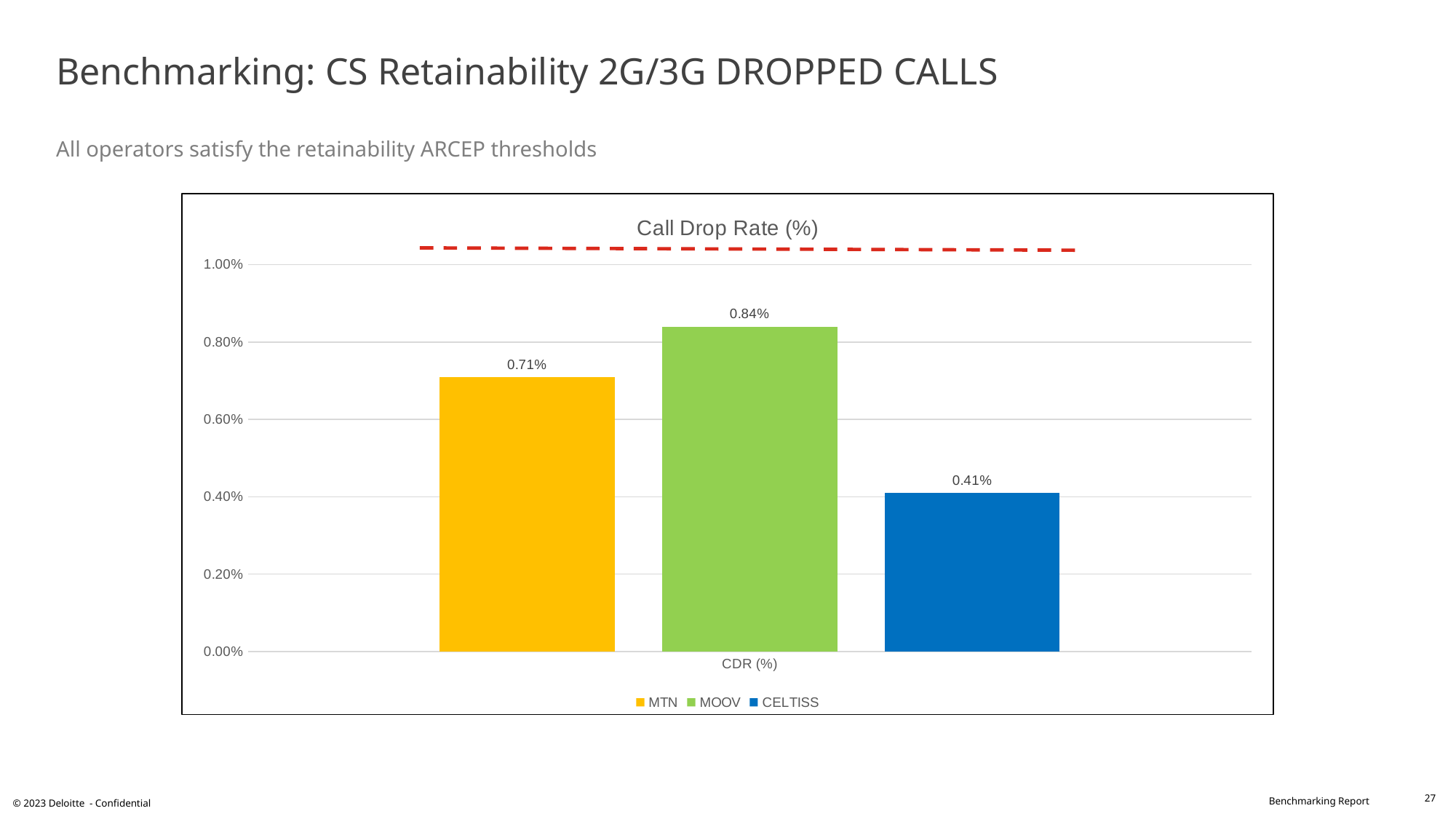
Which operator has the highest Call Drop Rate? MOOV How many series does the legend list? 3 What is the difference between the Call Drop Rate of MTN and CELTISS? 0.30% What kind of chart is shown on the slide? Bar chart What is the Call Drop Rate for CELTISS? 0.41% What is the difference between the Call Drop Rate of MOOV and MTN? 0.13% Is the Call Drop Rate for MOOV greater or less than 1.00%? less What is the Call Drop Rate for MTN? 0.71% What is the Call Drop Rate for MOOV? 0.84% Which operator has the lowest Call Drop Rate? CELTISS What is the title of the chart? Call Drop Rate (%) Which has a higher Call Drop Rate, MTN or CELTISS? MTN